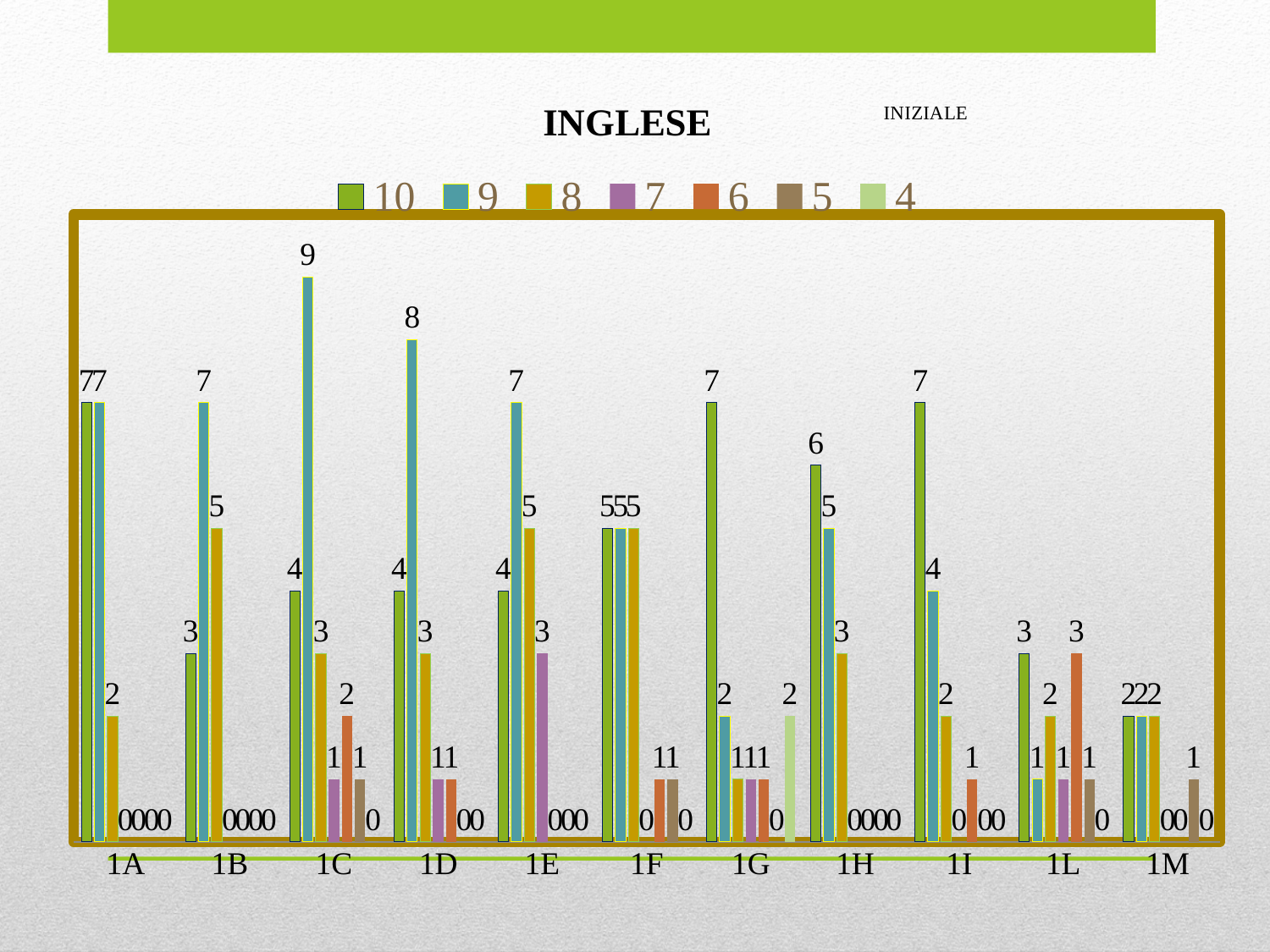
What kind of chart is shown on the slide? bar chart What is the difference between the series 9 value for 1D and the series 9 value for 1I? 4 What is the title of the chart? INGLESE Which is larger: the series 10 value for 1G or the series 10 value for 1L? 1G Which category has the highest value for series 4? 1G Which category has the highest value for series 9? 1C What is the total of all series values for category 1A? 16 What is the value of series 6 for category 1L? 3 How many categories are shown on the x axis? 11 What is the value of series 10 for category 1H? 6 What is the value of series 9 for category 1C? 9 How many series does the legend list? 7